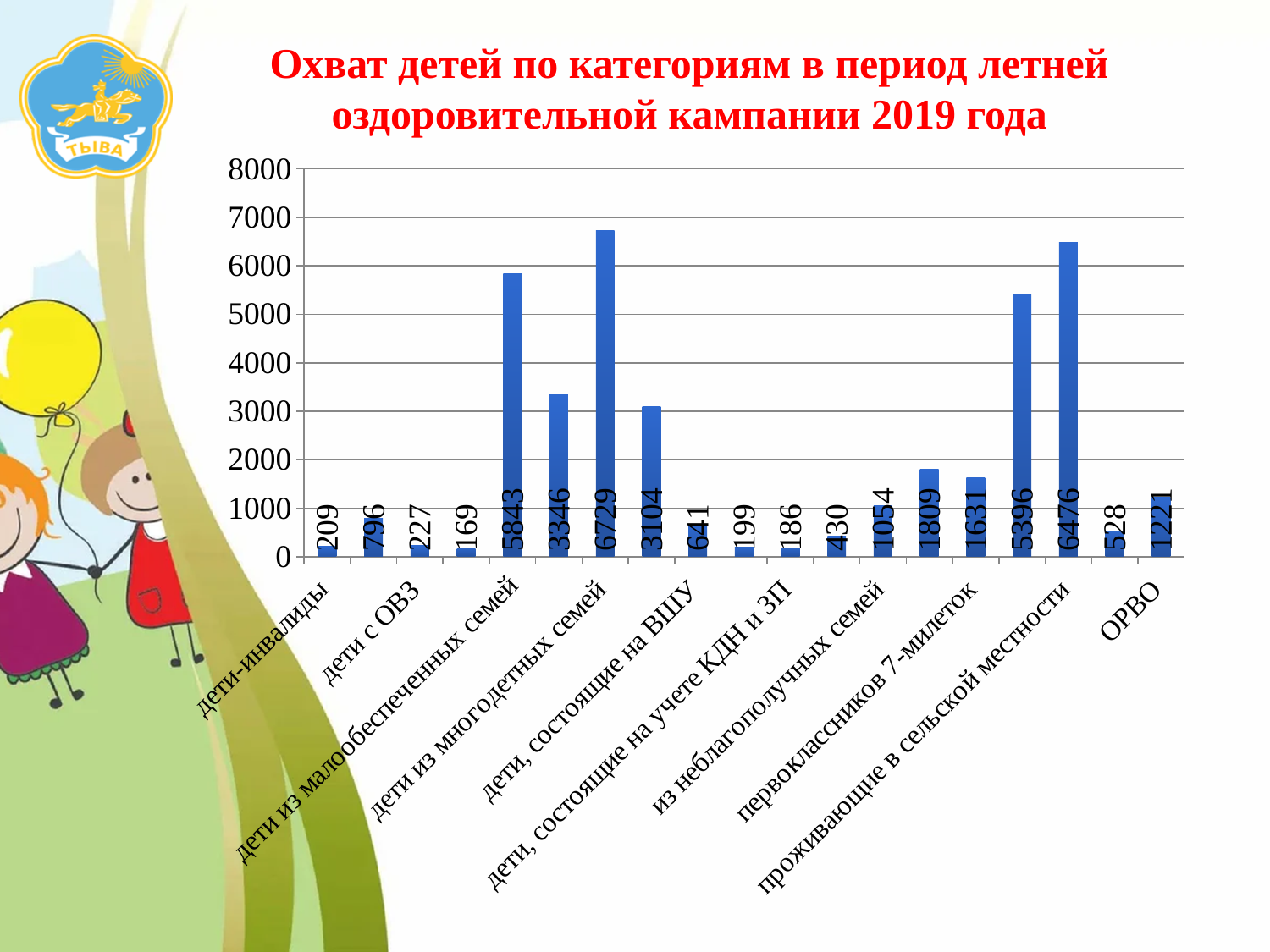
Is the value for проживающие в сельской местности greater or less than 6000? greater What is the value for дети из малообеспеченных семей? 5843 What is the value for дети-инвалиды? 209 What is the value for проживающие в сельской местности? 6476 How many bars are plotted in the chart? 19 What is the value for ОРВО? 1221 Which labelled category has the highest value? дети из многодетных семей What kind of chart is shown on the slide? bar chart What is the difference between the values for дети из многодетных семей and проживающие в сельской местности? 253 What is the value for дети из многодетных семей? 6729 What is the smallest value shown on any bar in the chart? 169 Which is larger: the value for дети из малообеспеченных семей or the value for проживающие в сельской местности? проживающие в сельской местности